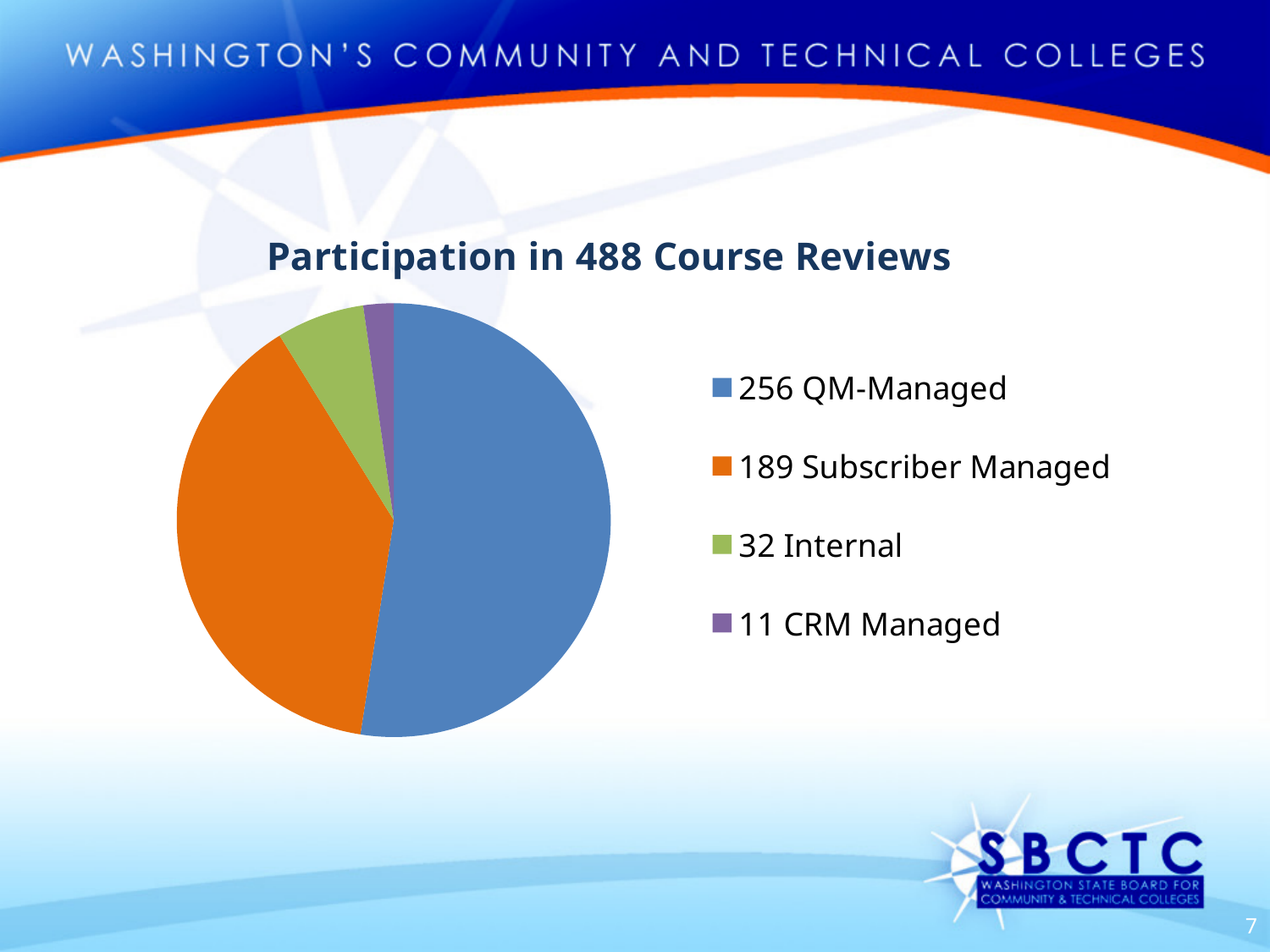
Which category has the largest share of the pie? QM-Managed Which is larger, the number of Internal reviews or the number of CRM Managed reviews? Internal How many course reviews were Subscriber Managed? 189 What is the title of the chart? Participation in 488 Course Reviews How many course reviews were Internal? 32 How many categories does the pie chart have? 4 How many course reviews were QM-Managed? 256 How many course reviews were CRM Managed? 11 What colour is the slice for Subscriber Managed? orange What is the difference between the number of QM-Managed and Subscriber Managed course reviews? 67 What kind of chart is shown on the slide? pie chart Which category has the smallest share of the pie? CRM Managed